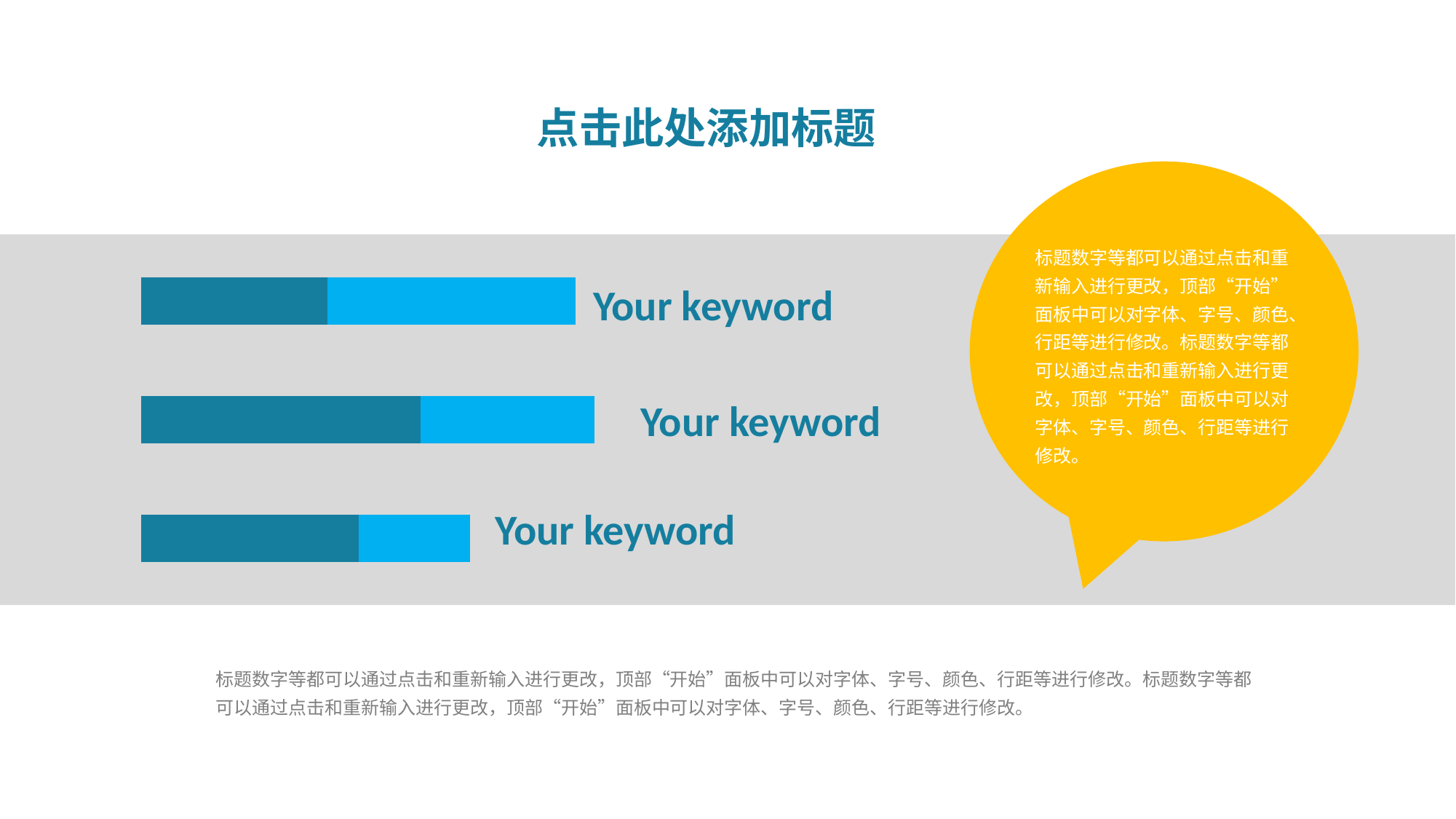
How many bars does the chart show? 3 Which bar in the chart is the shortest overall: the top, middle or bottom bar? bottom bar Which is longer overall, the top bar or the bottom bar? top bar How many coloured segments does each bar in the chart have? 2 What kind of chart is shown on the slide? bar chart Which is longer overall, the middle bar or the bottom bar? middle bar What label is shown next to each bar in the chart? Your keyword